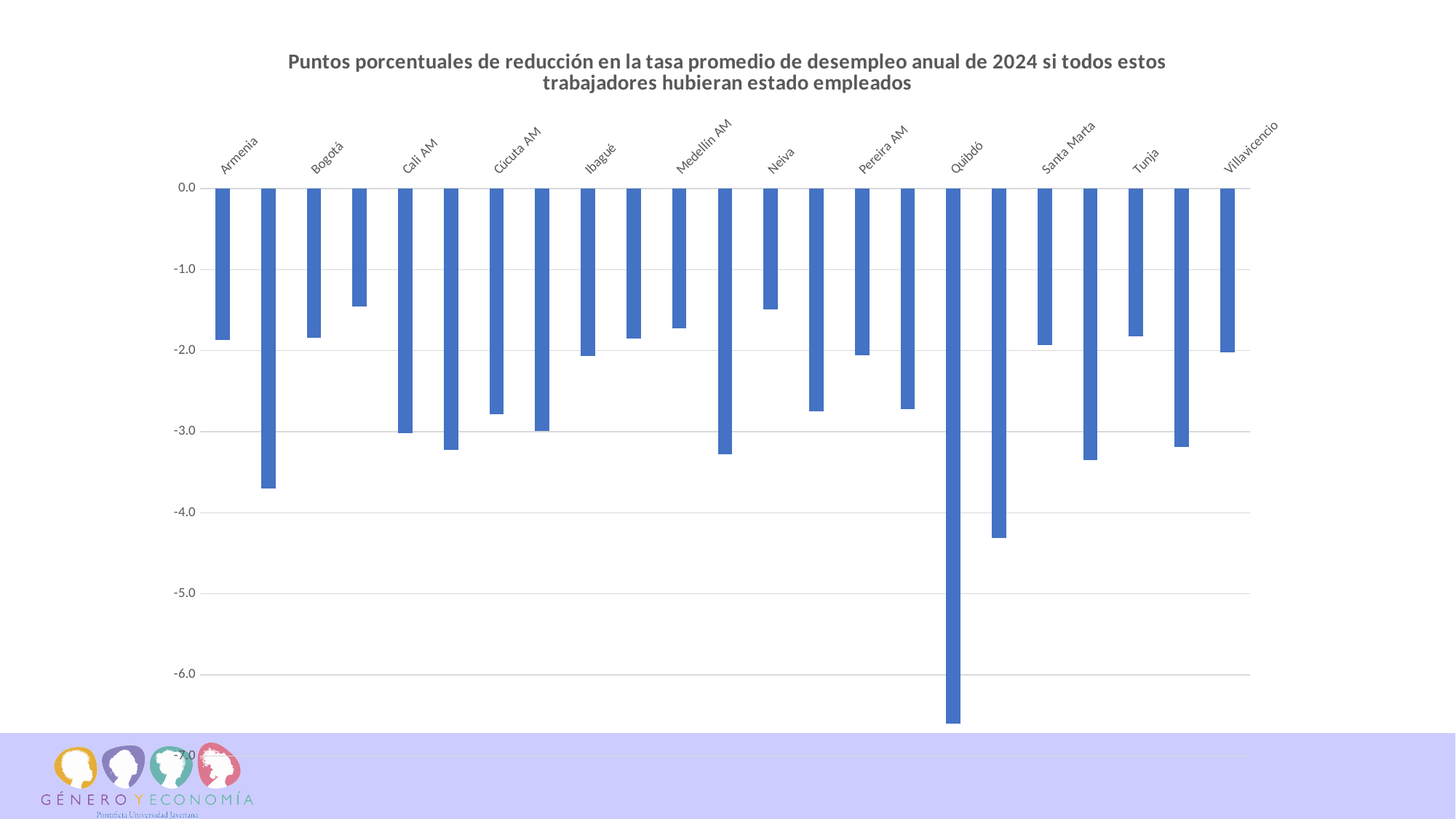
What is the lowest value labelled on the vertical axis of the chart? -7.0 Which city has the bar that reaches the lowest (most negative) value on the chart? Quibdó Is the value of the first bar for Armenia greater or less than -2.0? greater How many bars are plotted for each city on the chart? 1 Is the value of the first bar for Medellín AM greater or less than -2.0? greater What kind of chart is shown on the slide? Bar chart How many cities or metropolitan areas are shown on the x axis of the chart? 12